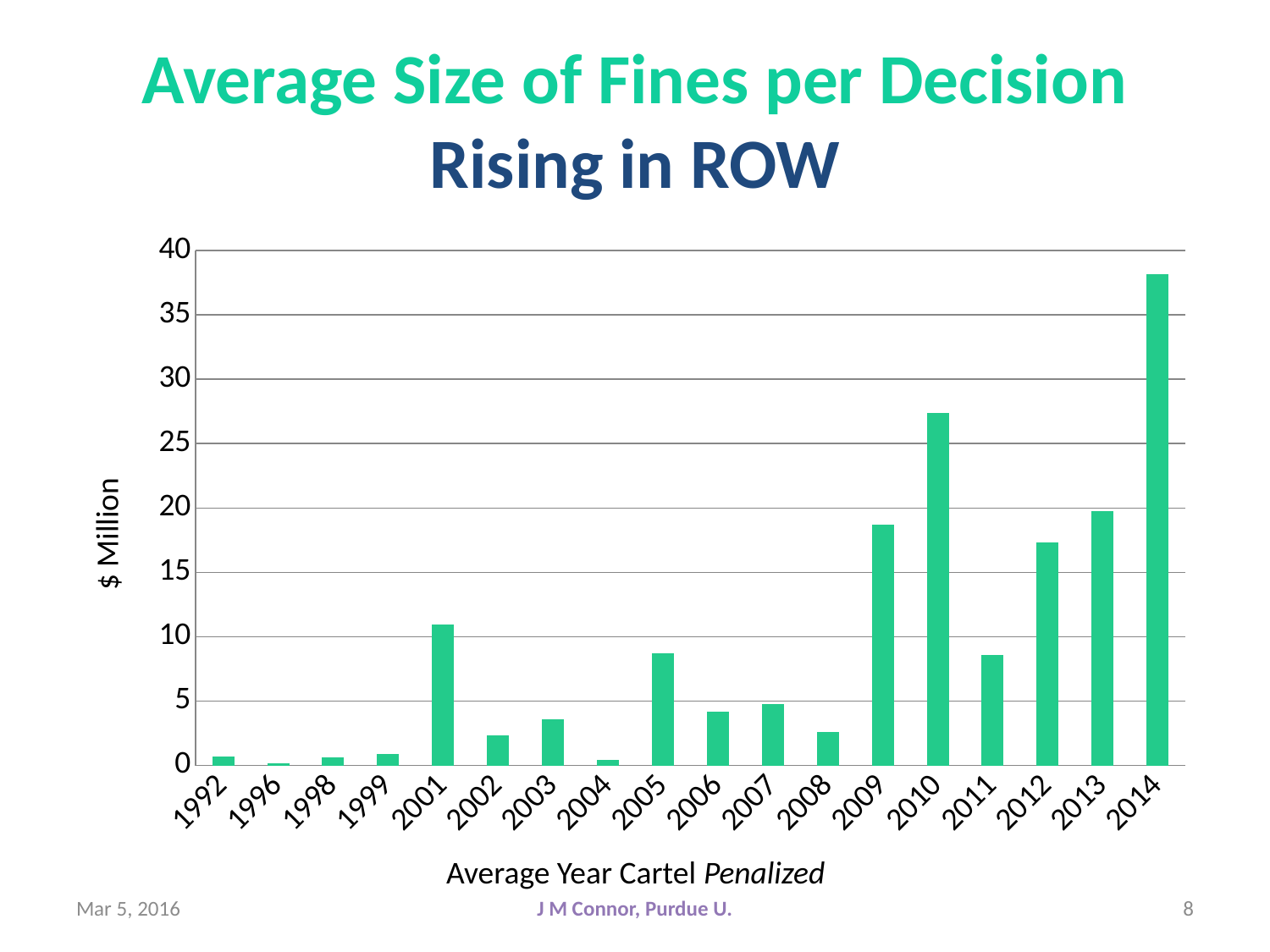
How many years are shown on the x axis of the chart? 18 Is the value for 2010 greater or less than 25? greater Which year has the larger value, 2009 or 2010? 2010 Is the value for 2011 greater or less than 10? less Which year has the highest average fine per decision? 2014 What kind of chart is shown on the slide? bar chart Which year has the larger value, 2001 or 2005? 2001 Is the value for 2006 greater or less than 5? less What is the label on the vertical axis of the chart? $ Million